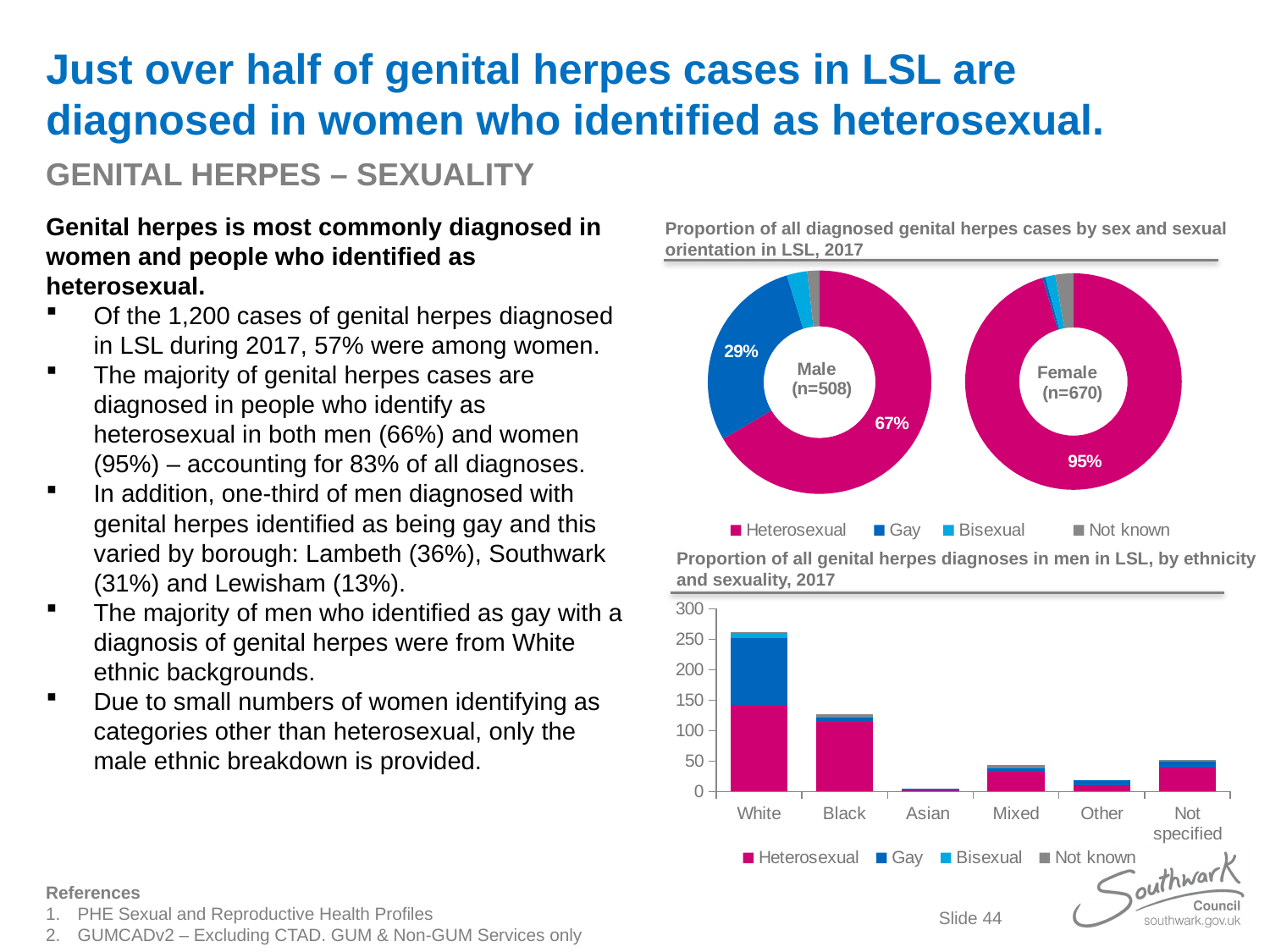
In the chart 'Proportion of all genital herpes diagnoses in men in LSL, by ethnicity and sexuality, 2017', which ethnicity has the tallest stacked bar? White In the chart 'Proportion of all diagnosed genital herpes cases by sex and sexual orientation in LSL, 2017', how many categories does the legend list? 4 In the chart 'Proportion of all diagnosed genital herpes cases by sex and sexual orientation in LSL, 2017', which sexual orientation category is the largest share for males? Heterosexual In the chart 'Proportion of all diagnosed genital herpes cases by sex and sexual orientation in LSL, 2017', what percentage of male cases identified as gay? 29% In the chart 'Proportion of all diagnosed genital herpes cases by sex and sexual orientation in LSL, 2017', what is the difference between the heterosexual share for females and the heterosexual share for males? 28% In the chart 'Proportion of all genital herpes diagnoses in men in LSL, by ethnicity and sexuality, 2017', is the total bar for Black greater or less than 150? less In the chart 'Proportion of all genital herpes diagnoses in men in LSL, by ethnicity and sexuality, 2017', is the total bar for White greater or less than 200? greater What type of chart is 'Proportion of all genital herpes diagnoses in men in LSL, by ethnicity and sexuality, 2017'? Stacked bar chart In the chart 'Proportion of all diagnosed genital herpes cases by sex and sexual orientation in LSL, 2017', what is the number of cases (n) shown for the Female donut? n=670 In the chart 'Proportion of all diagnosed genital herpes cases by sex and sexual orientation in LSL, 2017', what percentage of female cases identified as heterosexual? 95% In the chart 'Proportion of all diagnosed genital herpes cases by sex and sexual orientation in LSL, 2017', what percentage of male cases identified as heterosexual? 67% In the chart 'Proportion of all genital herpes diagnoses in men in LSL, by ethnicity and sexuality, 2017', how many ethnicity categories are shown on the x axis? 6